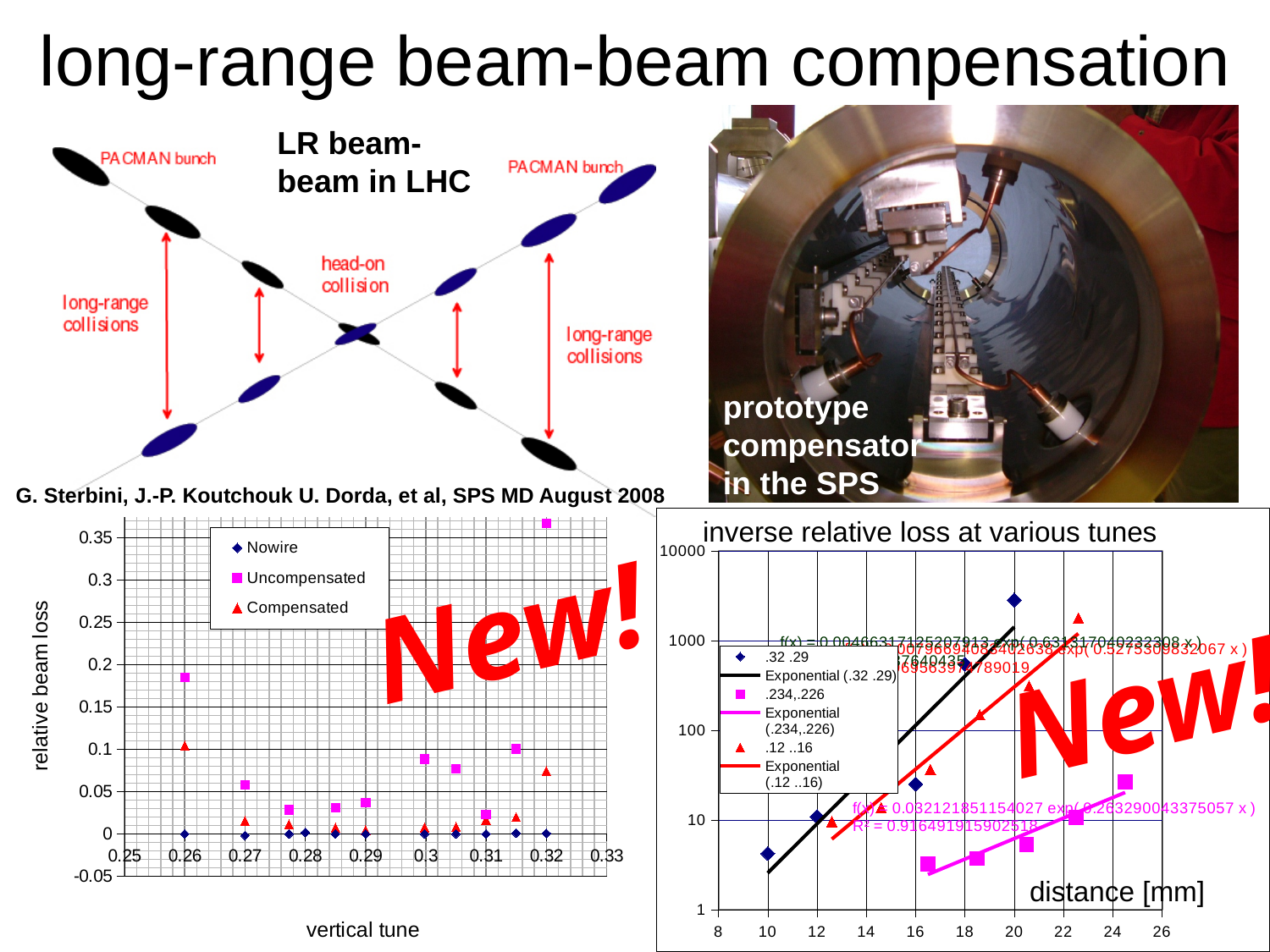
In the left chart, which series has all its points at 0 relative beam loss? Nowire In the right chart, which series has the lowest plotted points? .234,.226 In the left chart, is the Uncompensated value at vertical tune 0.26 greater or less than 0.15? greater In the left chart, which series has the highest plotted point? Uncompensated How many entries does the legend of the right chart list? 6 In the right chart, is the .32 .29 value at distance 20 mm greater or less than 1000? greater What kind of chart is the left chart (relative beam loss vs vertical tune)? scatter chart How many series does the legend of the left chart list? 3 What is the title of the right chart? inverse relative loss at various tunes What is the y-axis label of the left chart? relative beam loss In the left chart, is the Compensated value at vertical tune 0.26 greater or less than 0.05? greater In the right chart, do the plotted values rise or fall as distance increases? rise